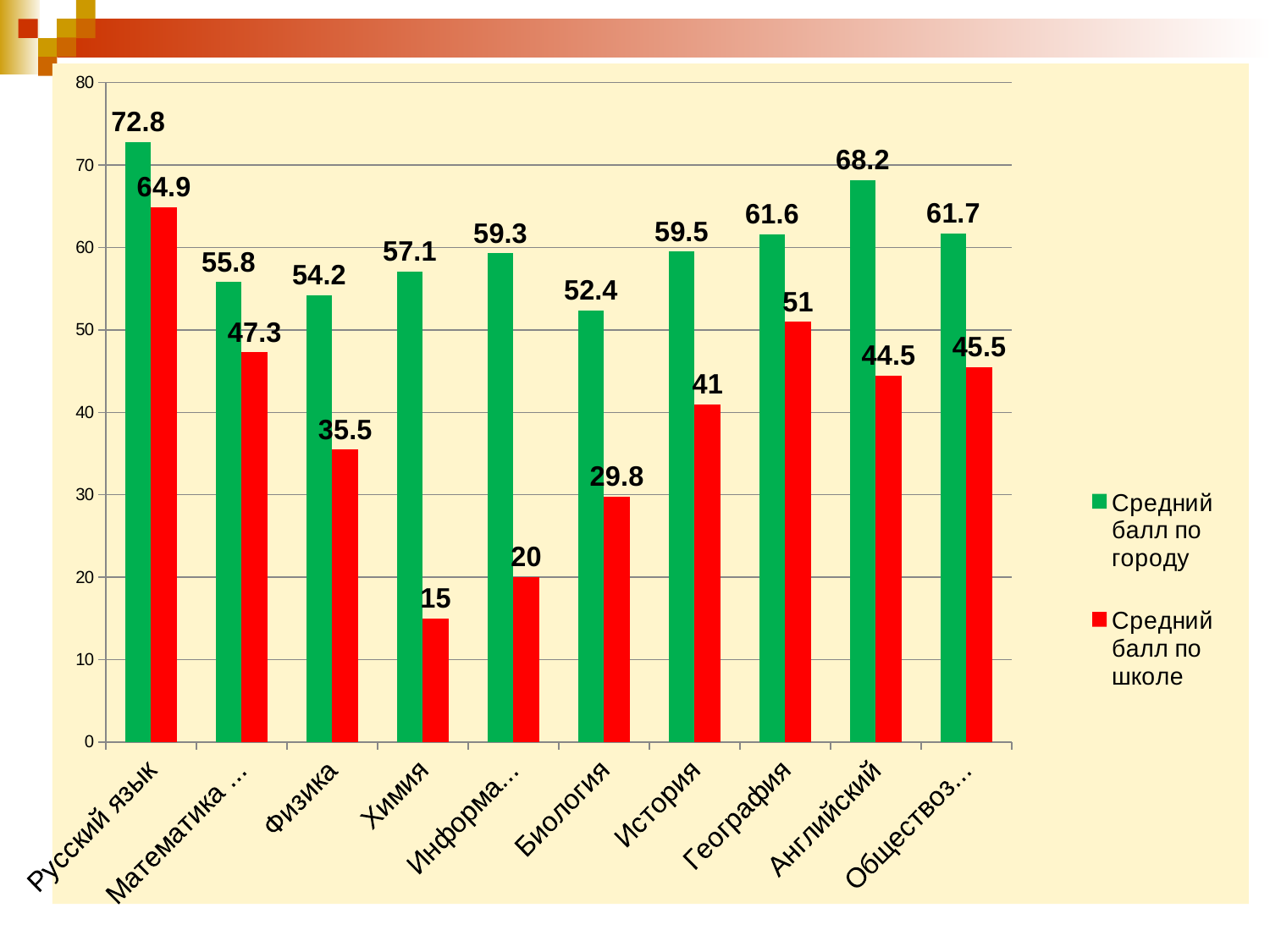
What is the value of "Средний балл по школе" for Химия? 15 How many categories are shown on the x axis? 10 Which category has the lowest value for "Средний балл по городу"? Биология What is the difference between "Средний балл по городу" and "Средний балл по школе" for Физика? 18.7 Which category has the lowest value for "Средний балл по школе"? Химия How many series does the legend list? 2 What kind of chart is shown on the slide? Bar chart What is the value of "Средний балл по городу" for Английский? 68.2 Which category has the highest value for "Средний балл по школе"? Русский язык What is the value of "Средний балл по городу" for Русский язык? 72.8 Which is larger for История: "Средний балл по городу" or "Средний балл по школе"? Средний балл по городу What is the value of "Средний балл по школе" for География? 51